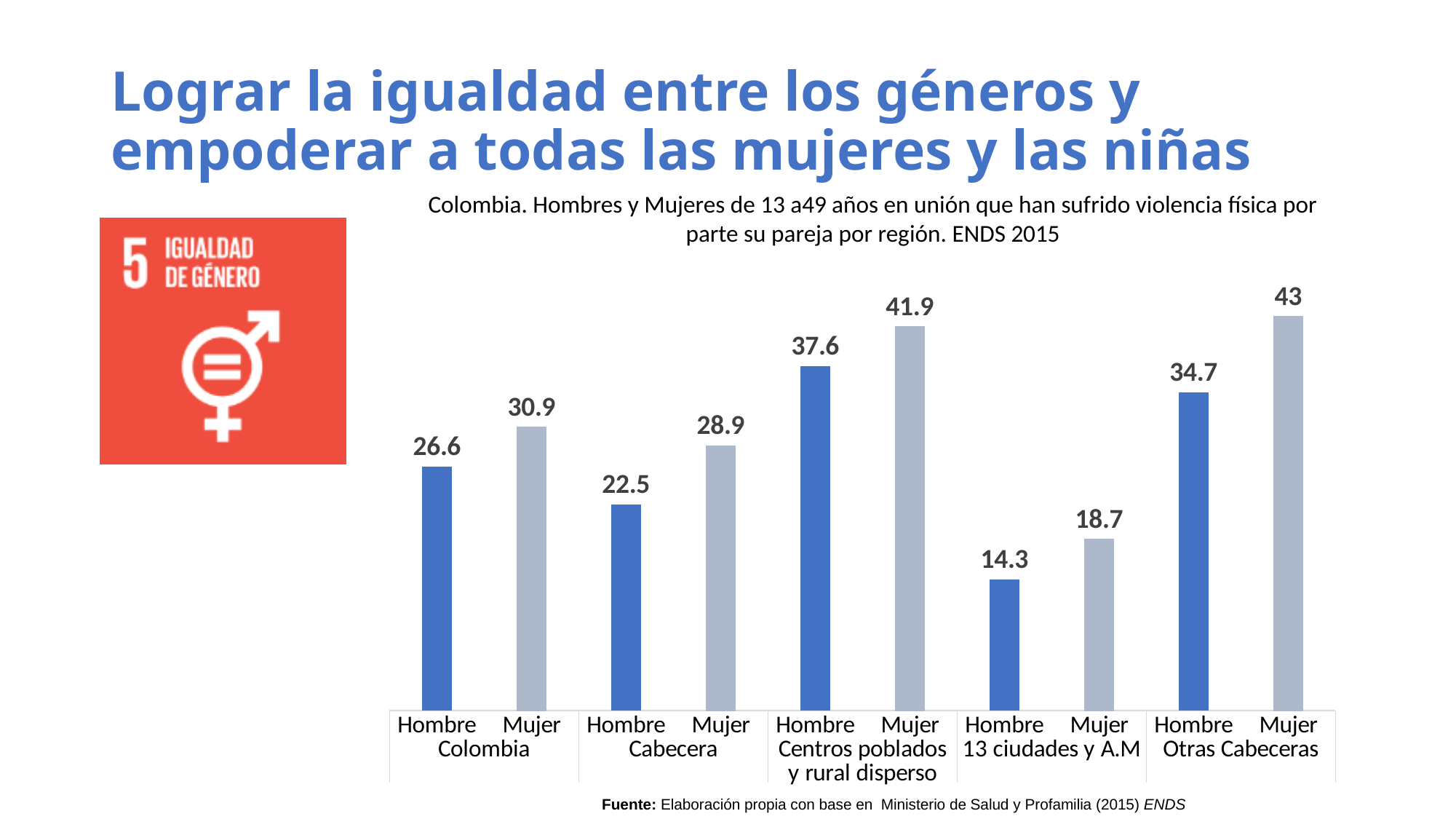
How many bars are plotted in the chart? 10 What is the value for Mujer in Colombia? 30.9 How many regions are shown along the x axis of the chart? 5 What is the difference between the Mujer and Hombre values in Cabecera? 6.4 What is the value for Mujer in 13 ciudades y A.M? 18.7 What type of chart is shown on the slide? Bar chart Which is larger, the Hombre value in Colombia or the Hombre value in Cabecera? Hombre in Colombia What is the value for Hombre in Centros poblados y rural disperso? 37.6 Which bar has the highest value in the chart? Mujer, Otras Cabeceras (43) What is the value for Hombre in Otras Cabeceras? 34.7 What is the difference between the Mujer and Hombre values in Centros poblados y rural disperso? 4.3 Which bar has the lowest value in the chart? Hombre, 13 ciudades y A.M (14.3)